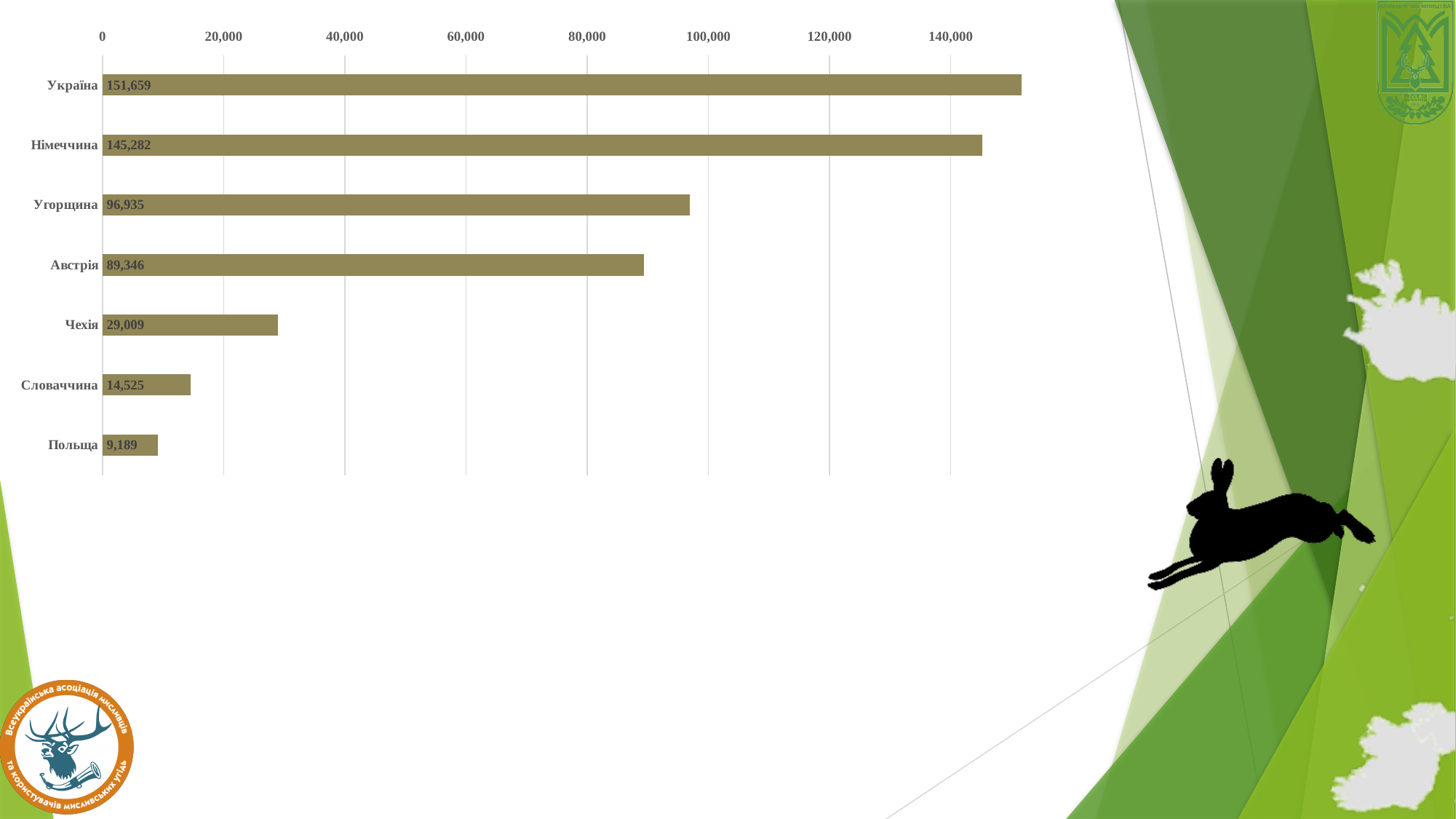
What is the value for Угорщина? 96,935 What is the highest tick label shown on the value axis? 140,000 What is the value for Словаччина? 14,525 Which category has the lowest value? Польща Is the value for Австрія greater or less than 80,000? greater What is the difference between the values for Чехія and Польща? 19,820 What is the difference between the values for Україна and Німеччина? 6,377 What kind of chart is shown on the slide? bar chart How many categories are shown in the chart? 7 Which is larger, the value for Угорщина or the value for Австрія? Угорщина What is the value for Україна? 151,659 Which category has the highest value? Україна